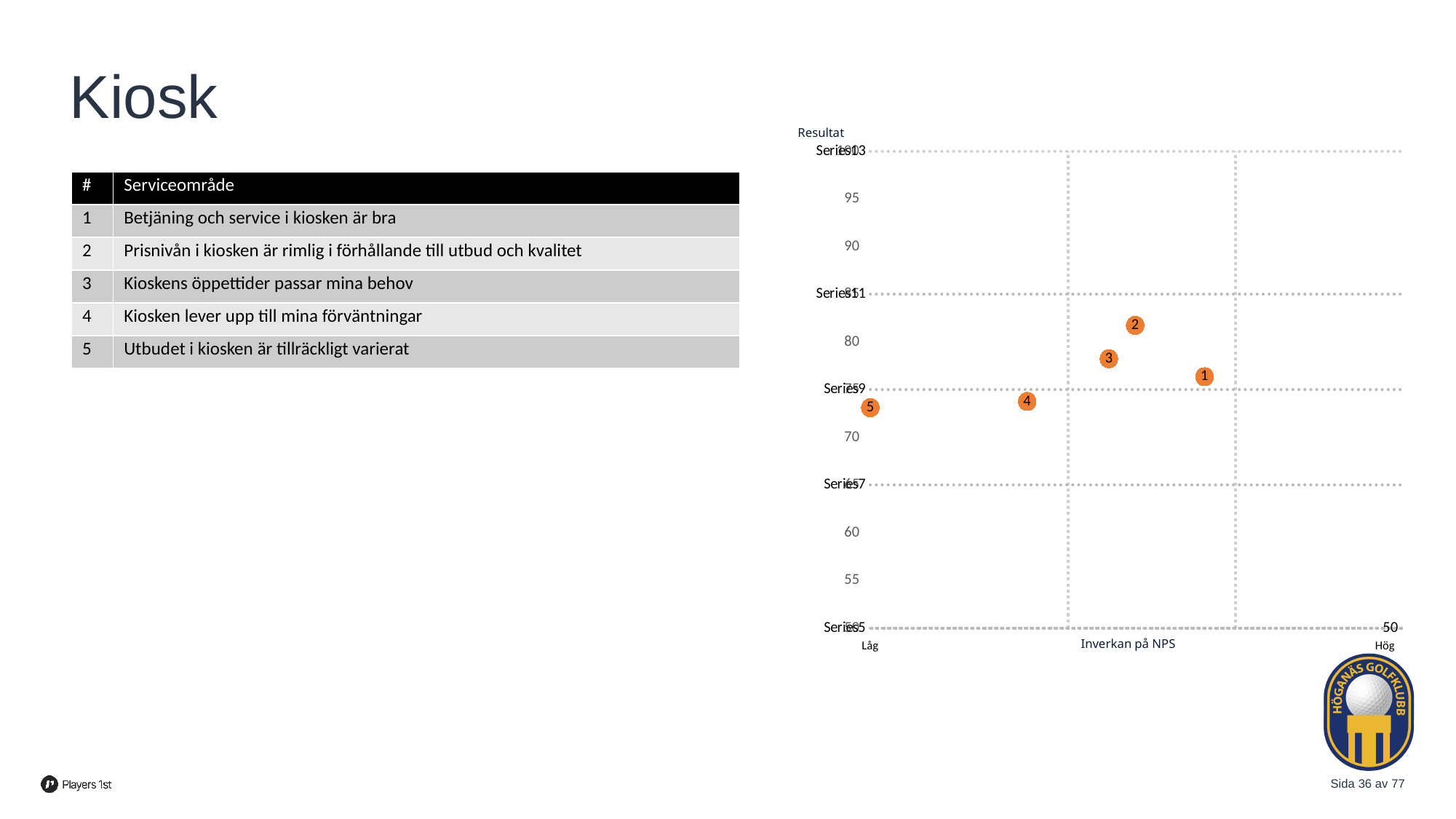
Is the Resultat value for point 5 greater or less than 70? greater What is the title of the horizontal axis of the chart? Inverkan på NPS What kind of chart is shown on the slide? scatter chart How many numbered points are plotted on the chart? 5 Which numbered point has the highest Resultat value on the chart? 2 Which numbered point is furthest to the right (highest Inverkan på NPS) on the chart? 1 Is the Resultat value for point 3 greater or less than 80? less Which has a higher Resultat value on the chart, point 2 or point 5? point 2 What is the title of the vertical axis of the chart? Resultat Is the Resultat value for point 4 greater or less than 75? less Which numbered point is furthest to the left (lowest Inverkan på NPS) on the chart? 5